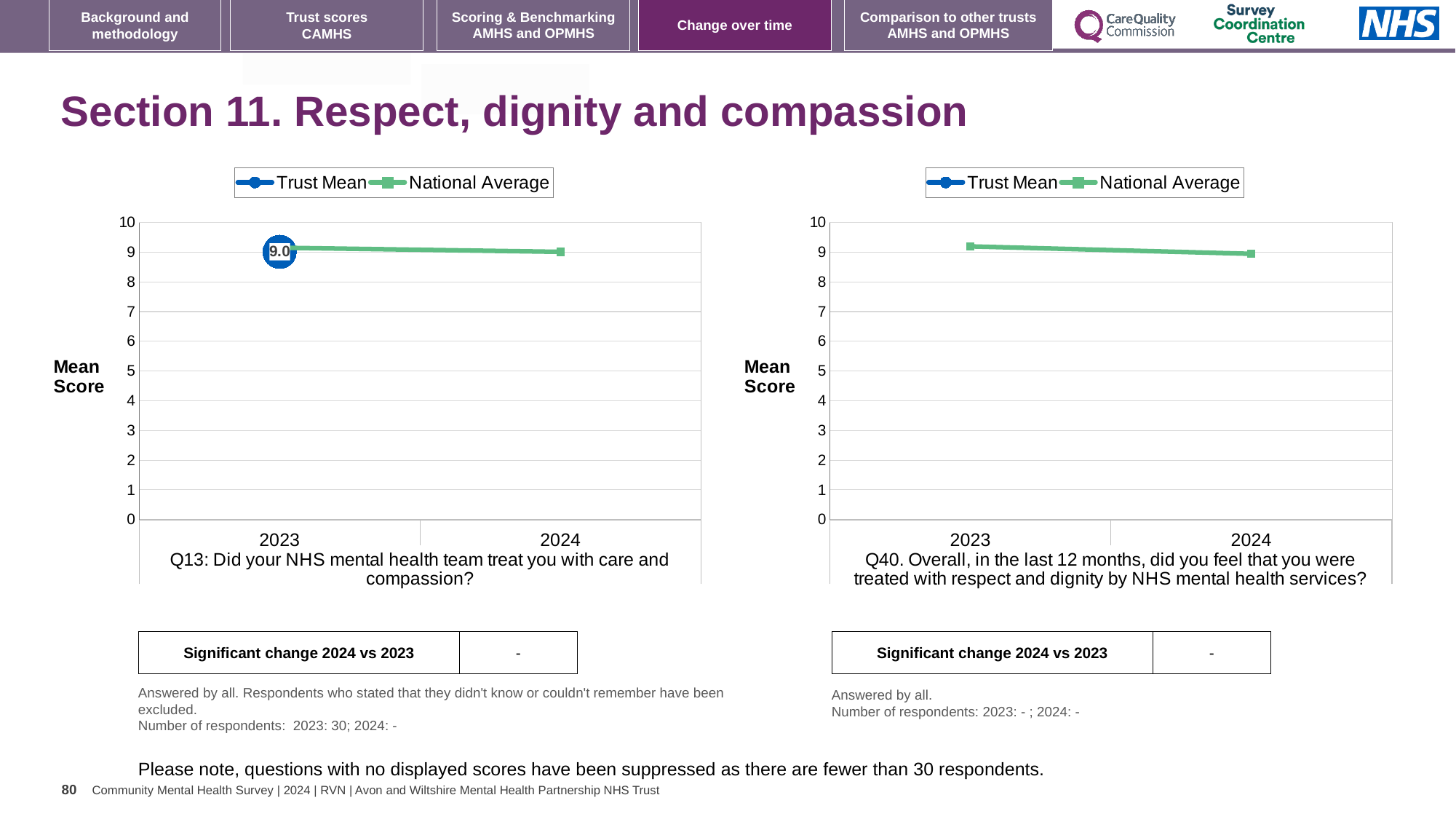
On the right chart (Q40), is the National Average value for 2023 greater or less than 5? greater On the right chart (Q40), does the National Average line rise or fall from 2023 to 2024? fall On the left chart (Q13), is the National Average value for 2024 greater or less than 8? greater What is the y-axis label on the right chart (Q40)? Mean Score How many years are shown on the x axis of the left chart (Q13)? 2 What is the maximum value shown on the y axis of the left chart (Q13)? 10 On the left chart (Q13), what is the Trust Mean value for 2023? 9.0 What kind of chart is the left chart (Q13)? line chart On the left chart (Q13), is the Trust Mean value for 2023 greater or less than 8? greater What are the two series named in the legend of the left chart (Q13)? Trust Mean and National Average How many series does the legend of the right chart (Q40) list? 2